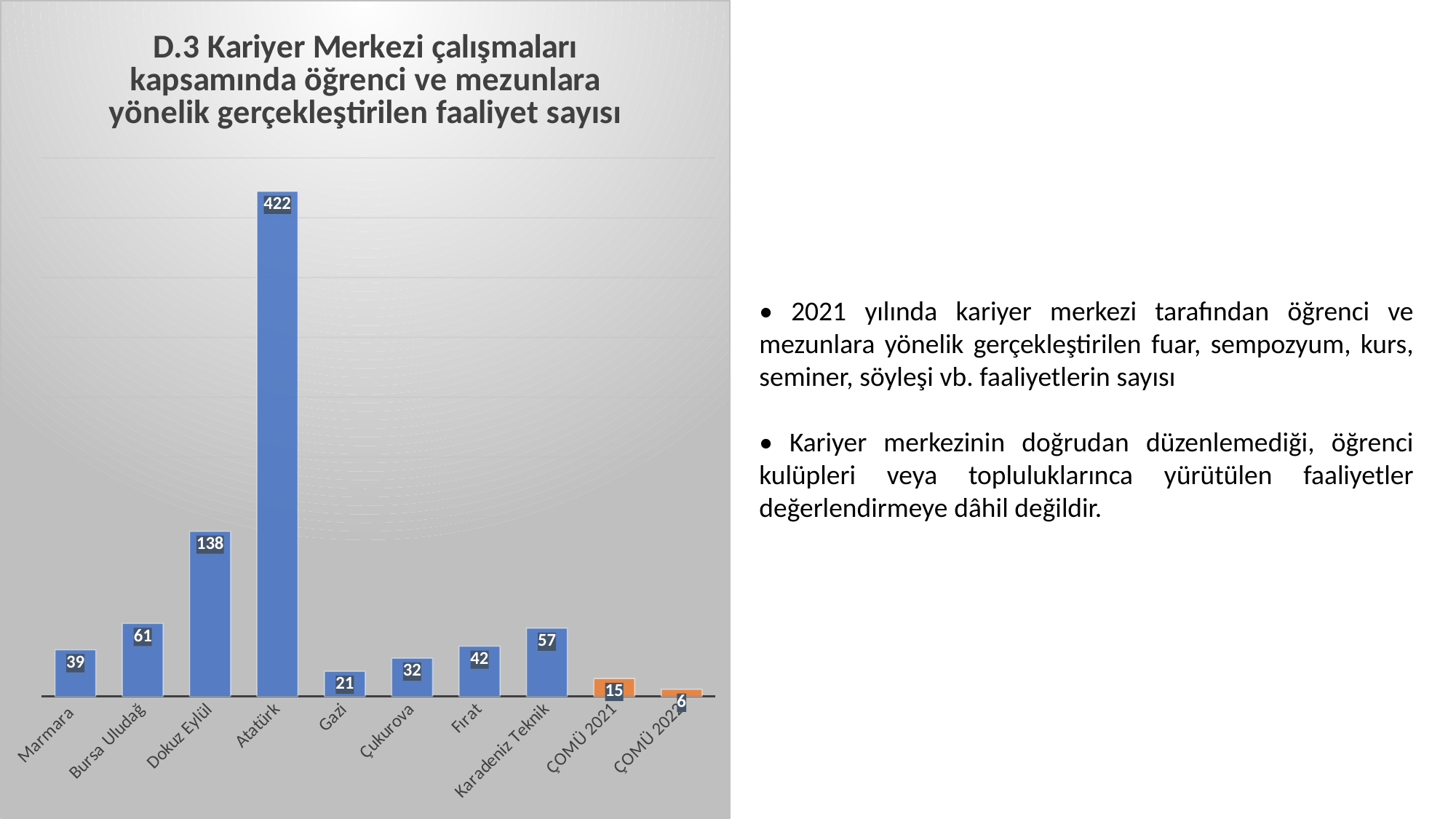
What kind of chart is shown on the slide? Bar chart What is the value for Dokuz Eylül? 138 How many bars are shown in the chart? 10 What is the value for ÇOMÜ 2021? 15 What is the value for Karadeniz Teknik? 57 Which categories are shown with orange bars instead of blue? ÇOMÜ 2021 and ÇOMÜ 2022 Which of the blue bars has the lowest value? Gazi Which is larger, the value for Fırat or the value for Çukurova? Fırat What is the difference between the values for Bursa Uludağ and Marmara? 22 What is the value for Atatürk? 422 Which category has the highest value? Atatürk What is the difference between the values for Dokuz Eylül and Karadeniz Teknik? 81